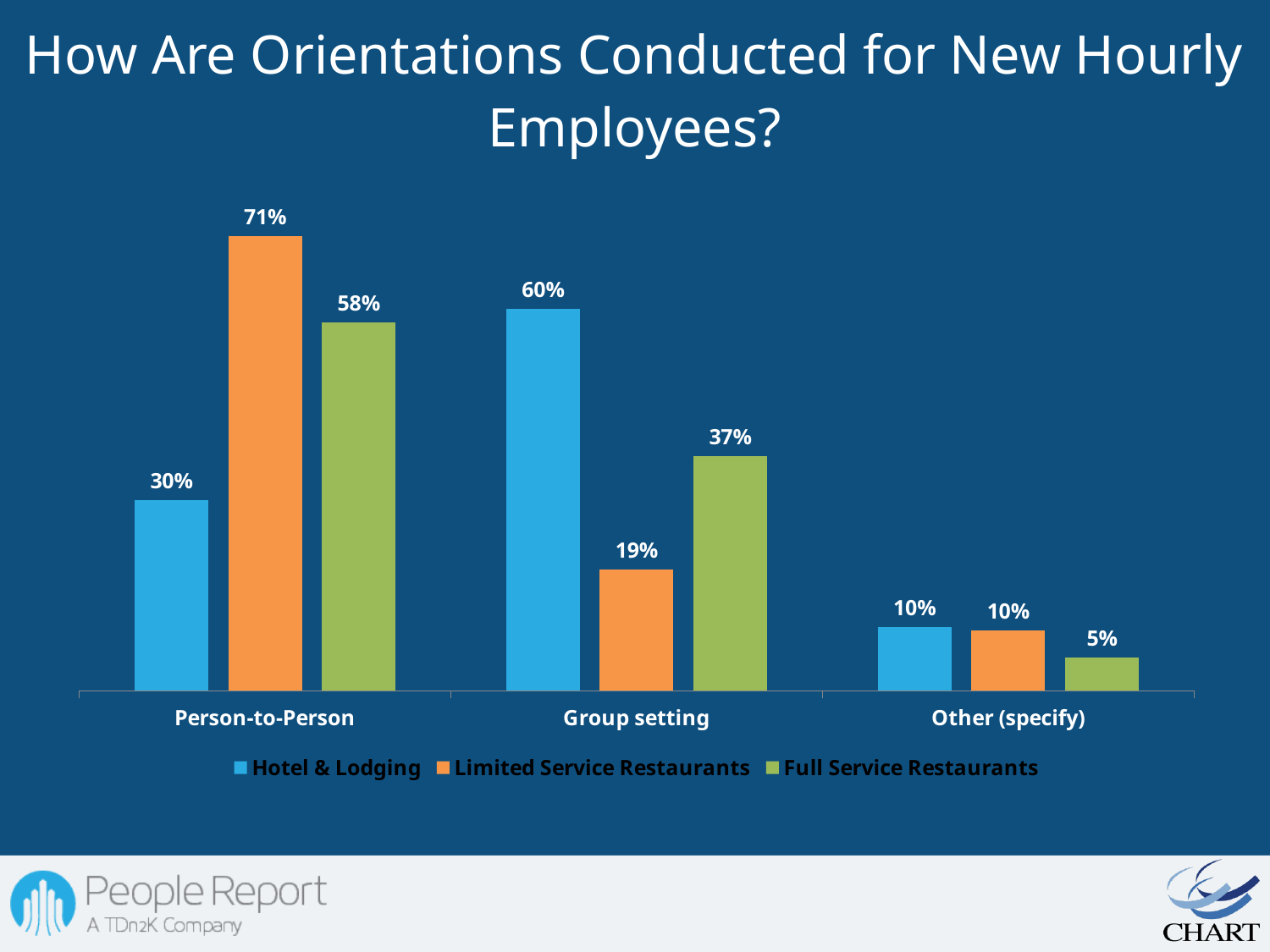
What kind of chart is shown on the slide? Bar chart How many series does the legend list? 3 What is the value for Full Service Restaurants in the Other (specify) category? 5% Which series has the highest value in the Person-to-Person category? Limited Service Restaurants What percentage of Limited Service Restaurants conduct orientations Person-to-Person? 71% How many categories are shown on the x axis? 3 Which colour represents Full Service Restaurants in the legend? Green What is the difference between the Hotel & Lodging and Full Service Restaurants values for Group setting? 23% What is the value for Hotel & Lodging in the Group setting category? 60% Which is larger: Full Service Restaurants for Person-to-Person or Full Service Restaurants for Group setting? Person-to-Person Which series has the lowest value in the Group setting category? Limited Service Restaurants What is the difference between the Limited Service Restaurants and Hotel & Lodging values for Person-to-Person? 41%